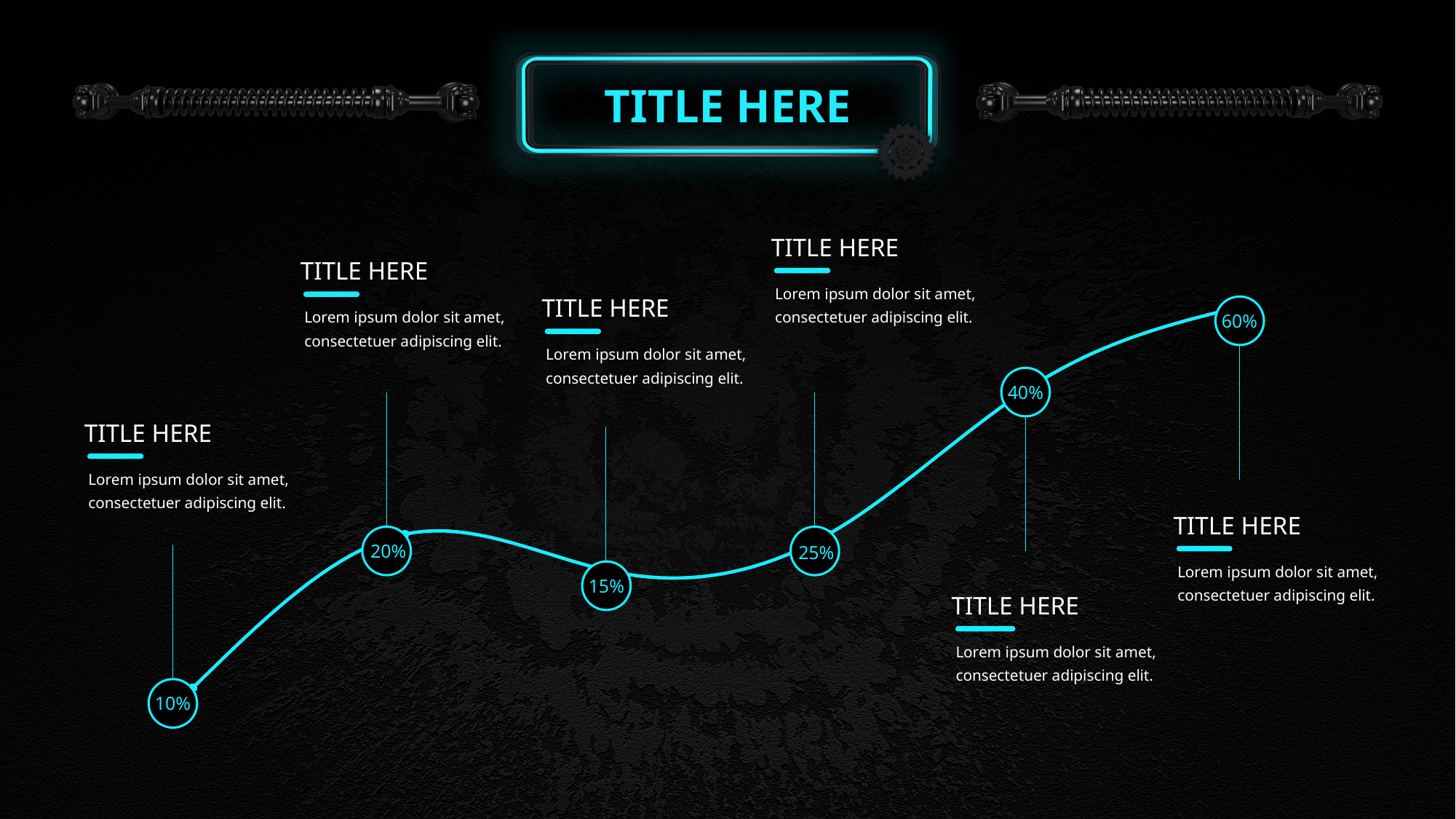
Does the line chart rise or fall between the second point and the third point? fall What is the lowest value shown on the line chart? 10% Which is larger on the line chart: the second point or the third point? the second point (20%) What colour is the line on the chart? cyan How many data points are plotted on the line chart? 6 What is the difference between the last point (60%) and the first point (10%) on the line chart? 50% What is the highest value shown on the line chart? 60% What is the value of the last (rightmost) point on the line chart? 60% What is the difference between the fifth point (40%) and the fourth point (25%) on the line chart? 15% What kind of chart is shown on the slide? line chart What is the value of the third point from the left on the line chart? 15% What is the value of the first (leftmost) point on the line chart? 10%